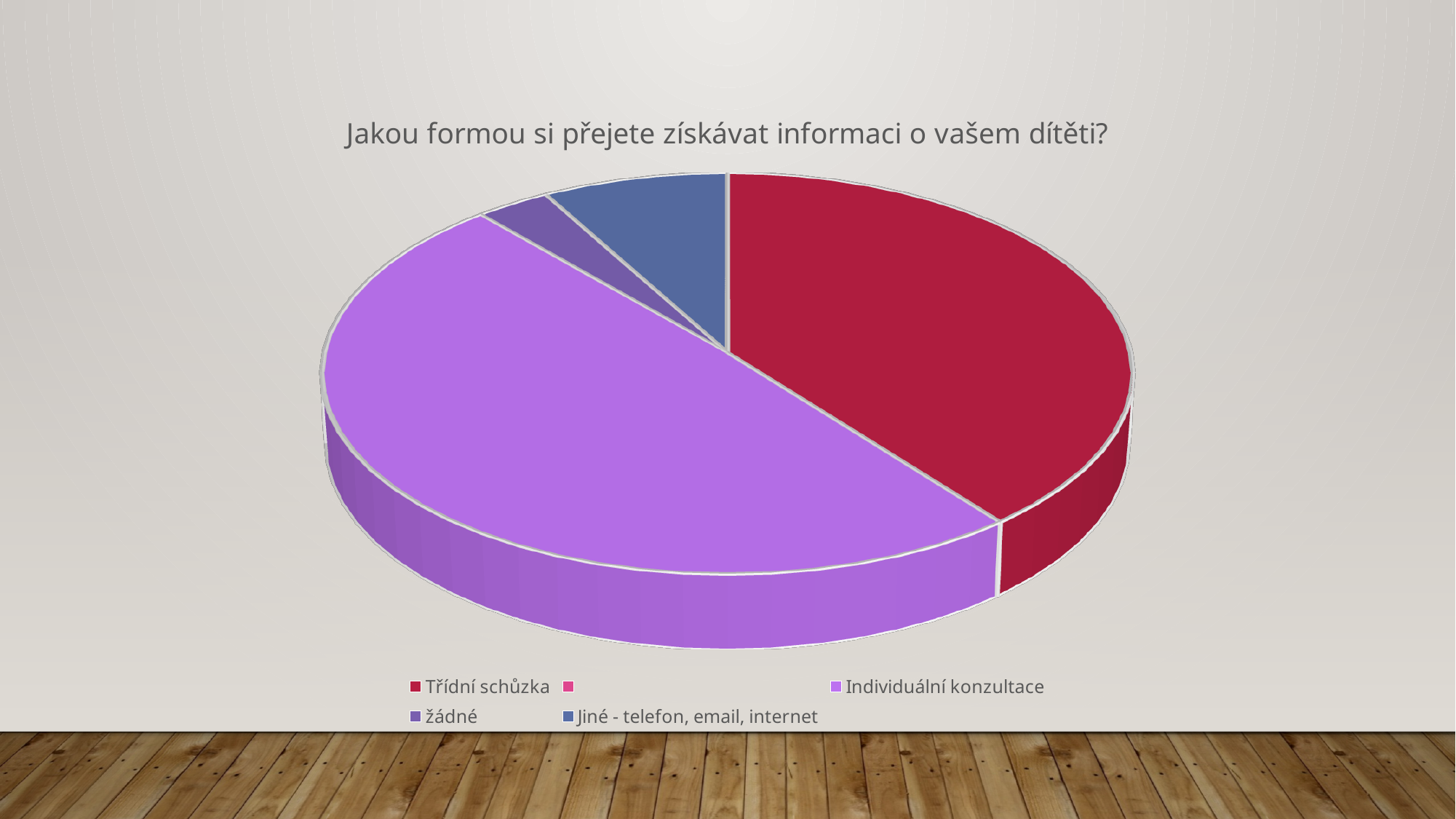
Which category has the largest slice of the pie? Individuální konzultace Which slice is larger, Individuální konzultace or Třídní schůzka? Individuální konzultace How many slices are visible in the pie? 4 Which slice is larger, Třídní schůzka or Jiné - telefon, email, internet? Třídní schůzka What kind of chart is shown on the slide? pie chart Which labelled category has the smallest visible slice of the pie? žádné Which category is shown in blue? Jiné - telefon, email, internet What is the title of the chart? Jakou formou si přejete získávat informaci o vašem dítěti? What colour is the slice for Třídní schůzka? red Which slice is larger, Jiné - telefon, email, internet or žádné? Jiné - telefon, email, internet